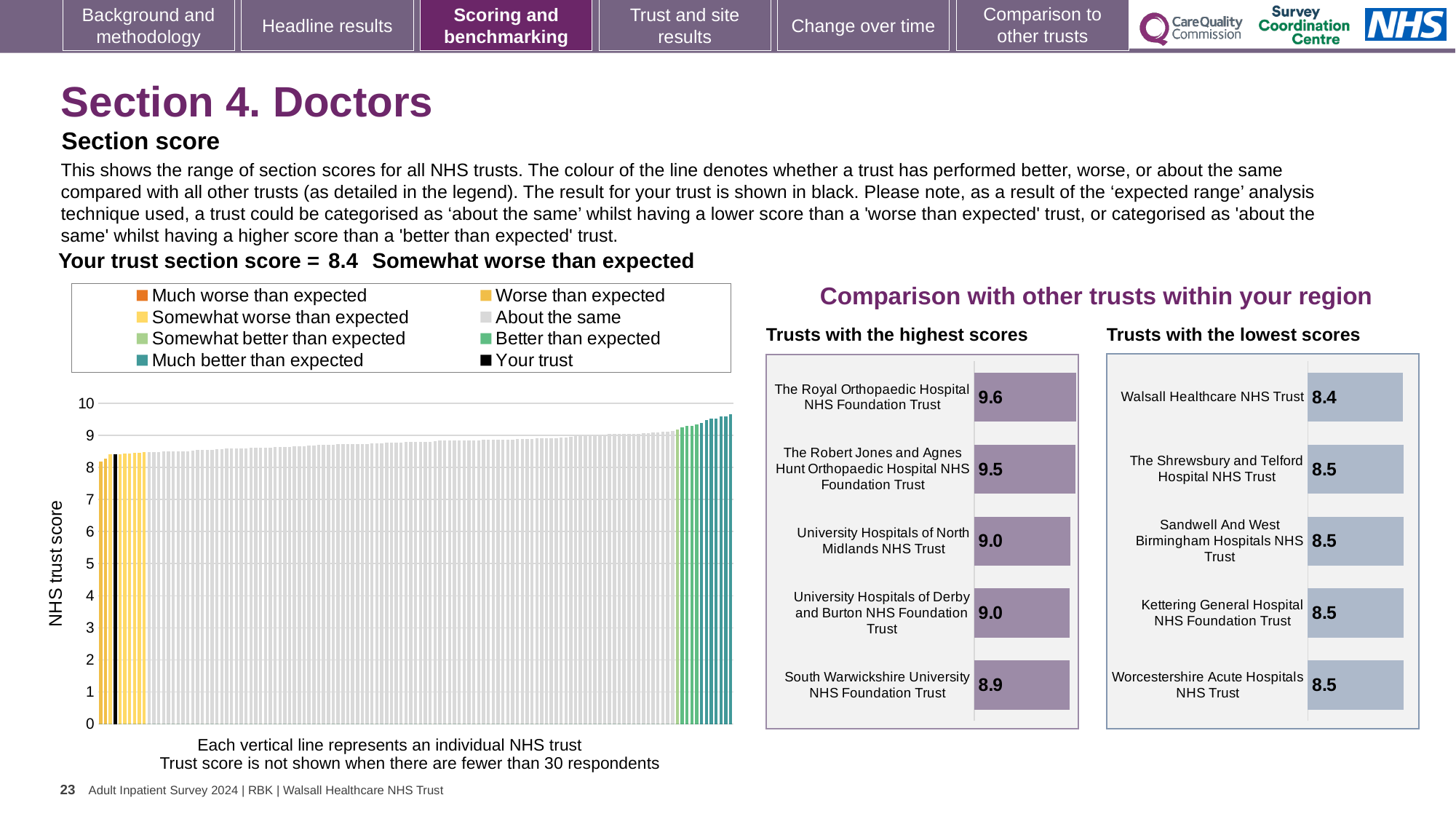
In the 'Trusts with the highest scores' chart, which has the higher score: The Robert Jones and Agnes Hunt Orthopaedic Hospital NHS Foundation Trust or University Hospitals of North Midlands NHS Trust? The Robert Jones and Agnes Hunt Orthopaedic Hospital NHS Foundation Trust In the 'Trusts with the lowest scores' chart, which trust has the lowest score? Walsall Healthcare NHS Trust How many entries does the legend of the large chart on the left list? 8 How many trusts are listed in the 'Trusts with the highest scores' chart? 5 In the large chart on the left, do the trust scores rise or fall from left to right? Rise In the 'Trusts with the lowest scores' chart, what is the difference between the scores of The Shrewsbury and Telford Hospital NHS Trust and Walsall Healthcare NHS Trust? 0.1 In the 'Trusts with the highest scores' chart, what is the score for The Royal Orthopaedic Hospital NHS Foundation Trust? 9.6 In the 'Trusts with the highest scores' chart, what is the difference between the scores of The Royal Orthopaedic Hospital NHS Foundation Trust and South Warwickshire University NHS Foundation Trust? 0.7 In the 'Trusts with the lowest scores' chart, what is the score for Walsall Healthcare NHS Trust? 8.4 In the 'Trusts with the highest scores' chart, which trust has the highest score? The Royal Orthopaedic Hospital NHS Foundation Trust How many trusts are listed in the 'Trusts with the lowest scores' chart? 5 What kind of chart is the large chart on the left showing NHS trust scores? Bar chart